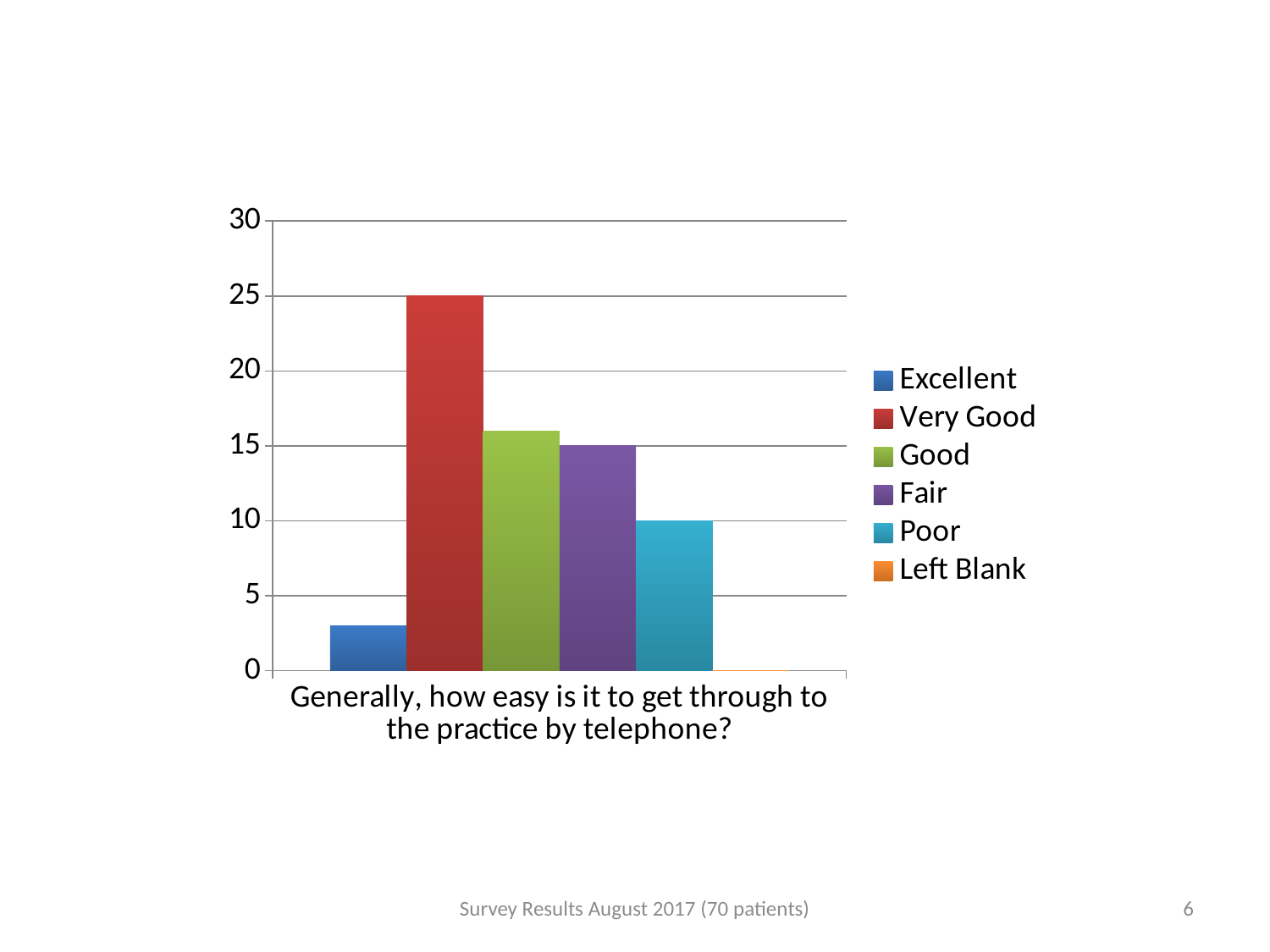
Which response has the lowest bar? Left Blank Is the value for Excellent greater or less than 5? less Which is larger, the value for Excellent or the value for Poor? Poor What question does the chart's category label show? Generally, how easy is it to get through to the practice by telephone? What kind of chart is shown on the slide? bar chart How many series does the legend list? 6 What is the difference between the Very Good and Fair values? 10 What is the value for Poor? 10 Which response has the highest bar? Very Good What is the difference between the Fair and Poor values? 5 What is the value for Very Good? 25 What is the value for Fair? 15